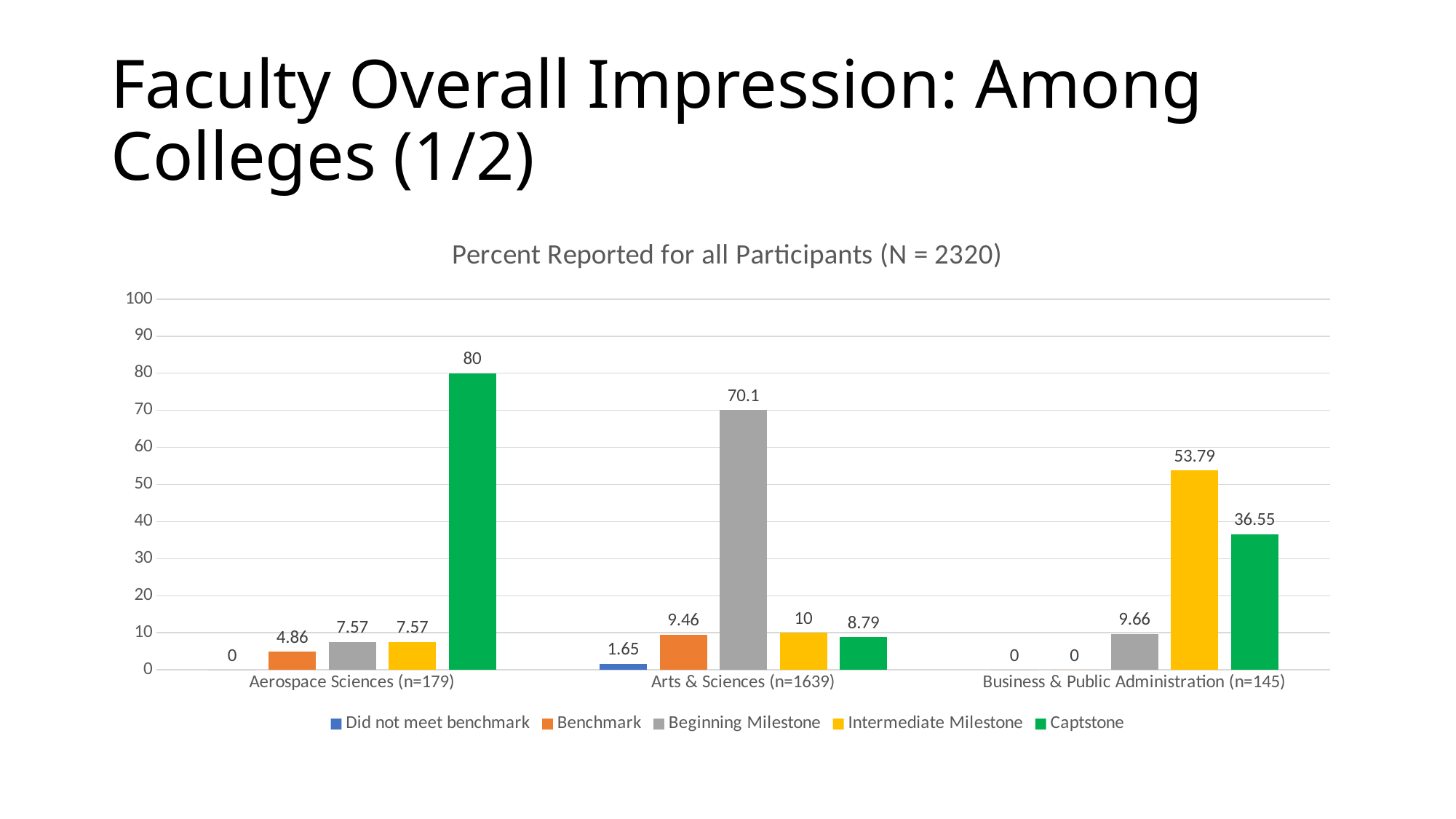
What is the title of the chart? Percent Reported for all Participants (N = 2320) Which college has the lowest Beginning Milestone value? Aerospace Sciences (n=179) What is the Beginning Milestone value for Arts & Sciences (n=1639)? 70.1 Which college has the highest Captstone value? Aerospace Sciences (n=179) What is the Did not meet benchmark value for Arts & Sciences (n=1639)? 1.65 What is the Captstone value for Aerospace Sciences (n=179)? 80 What is the Intermediate Milestone value for Business & Public Administration (n=145)? 53.79 How many series does the legend list? 5 What kind of chart is shown? Bar chart Which is larger: the Benchmark value for Arts & Sciences (n=1639) or for Aerospace Sciences (n=179)? Arts & Sciences (n=1639) How many colleges are shown on the x axis? 3 What is the difference between the Captstone values for Aerospace Sciences (n=179) and Business & Public Administration (n=145)? 43.45